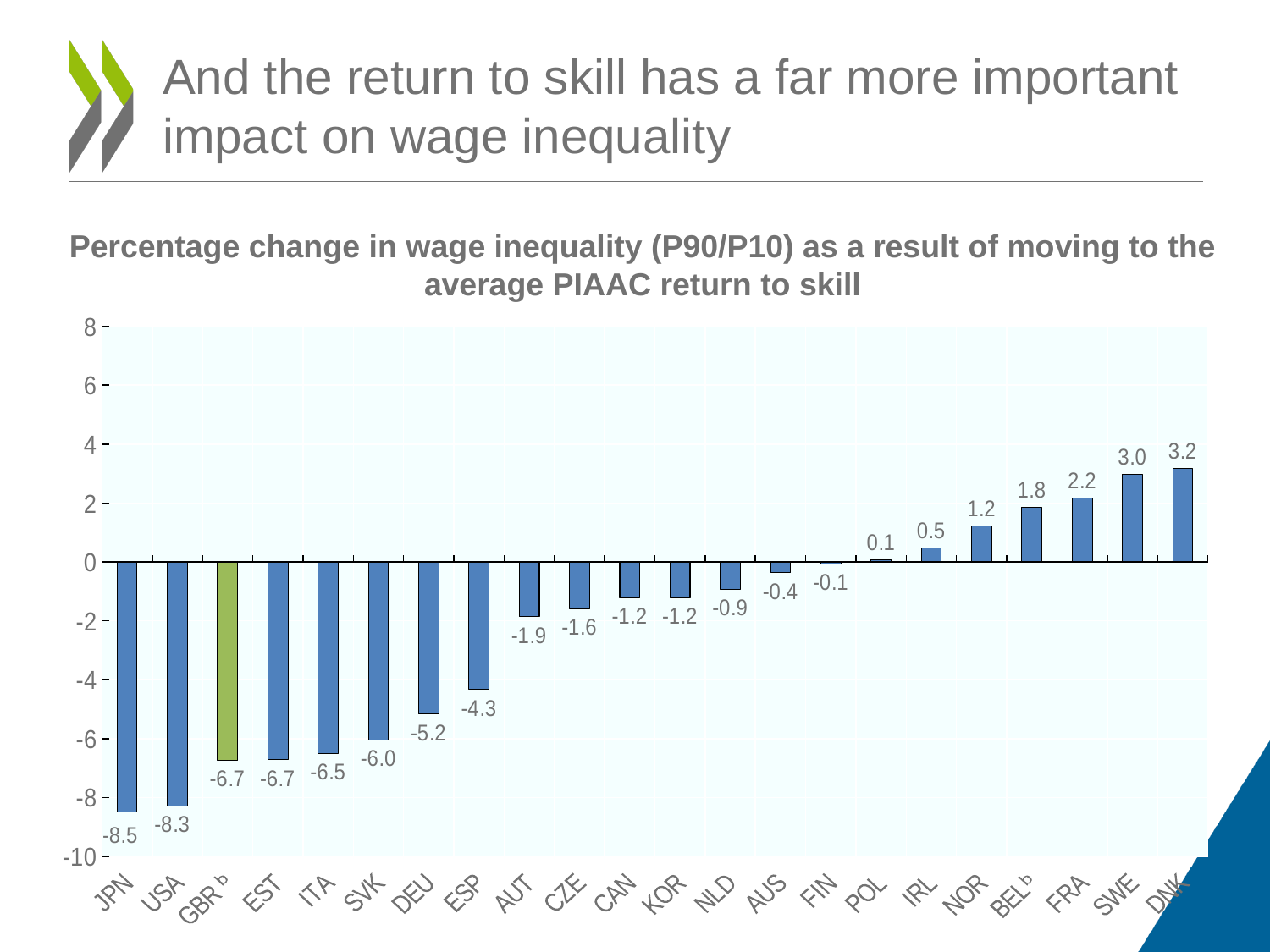
Is the value for ITA greater or less than -4? less What is the value for NOR? 1.2 What is the value for JPN? -8.5 Which country has the lowest value? JPN What is the difference between the values for SWE and FRA? 0.8 What is the value for DEU? -5.2 How many countries are shown on the x axis? 22 Do the values rise or fall moving from left to right along the x axis? rise Which country has the highest value? DNK Which country's bar is coloured green instead of blue? GBR Which is larger, the value for ESP or the value for AUT? AUT What kind of chart is this? bar chart